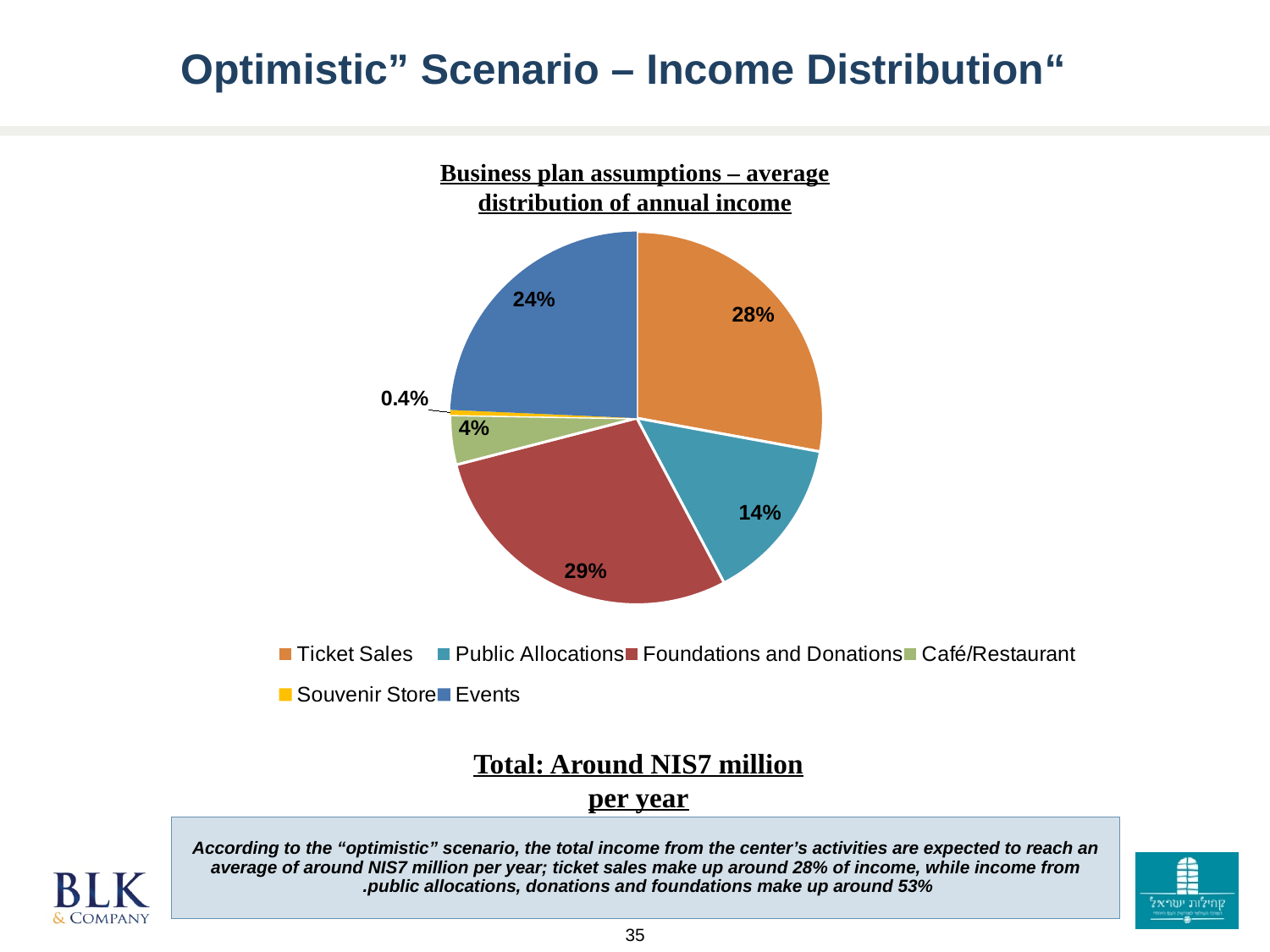
What is the difference in percentage points between the Events share and the Public Allocations share? 10 percentage points What share of annual income comes from Foundations and Donations? 29% Which income source has the smallest share of the pie? Souvenir Store Which income source has the largest share of the pie? Foundations and Donations What share of annual income comes from the Souvenir Store? 0.4% Which is larger, the share for Café/Restaurant or the share for Public Allocations? Public Allocations What share of annual income comes from Ticket Sales? 28% What share of annual income comes from Public Allocations? 14% What type of chart is shown on the slide? Pie chart What is the title of the chart? Business plan assumptions – average distribution of annual income What share of annual income comes from Events? 24% How many income categories does the pie chart show? 6